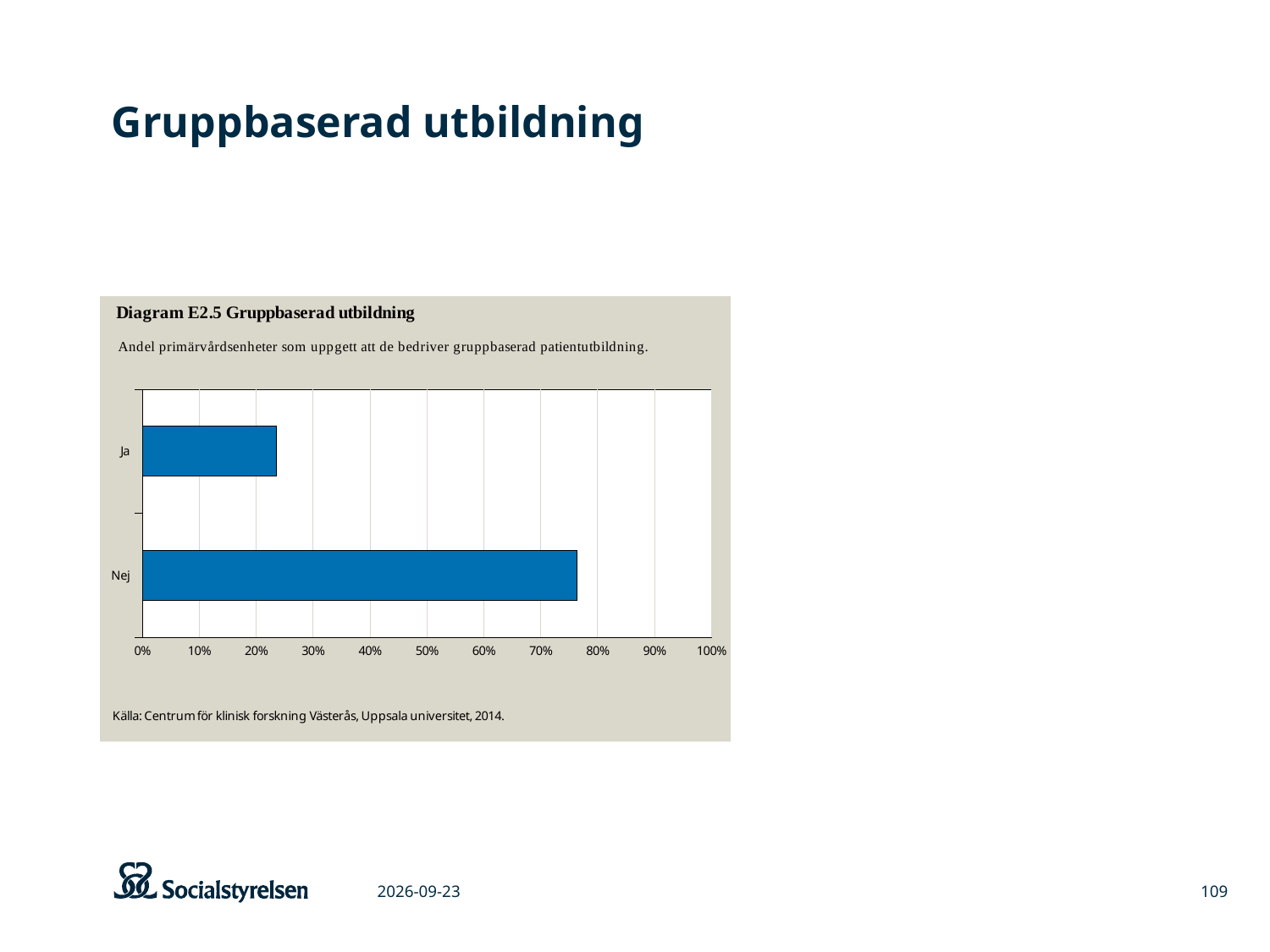
Is the value for Ja greater or less than 20%? greater How many categories are plotted in the chart? 2 Is the value for Nej greater or less than 70%? greater Is the value for Nej greater or less than 80%? less Which category has the highest value? Nej What kind of chart is shown on the slide? bar chart Which category has the lowest value? Ja Which is larger, the value for Ja or the value for Nej? Nej What is the maximum value shown on the x axis? 100% What is the title of the diagram? Diagram E2.5 Gruppbaserad utbildning